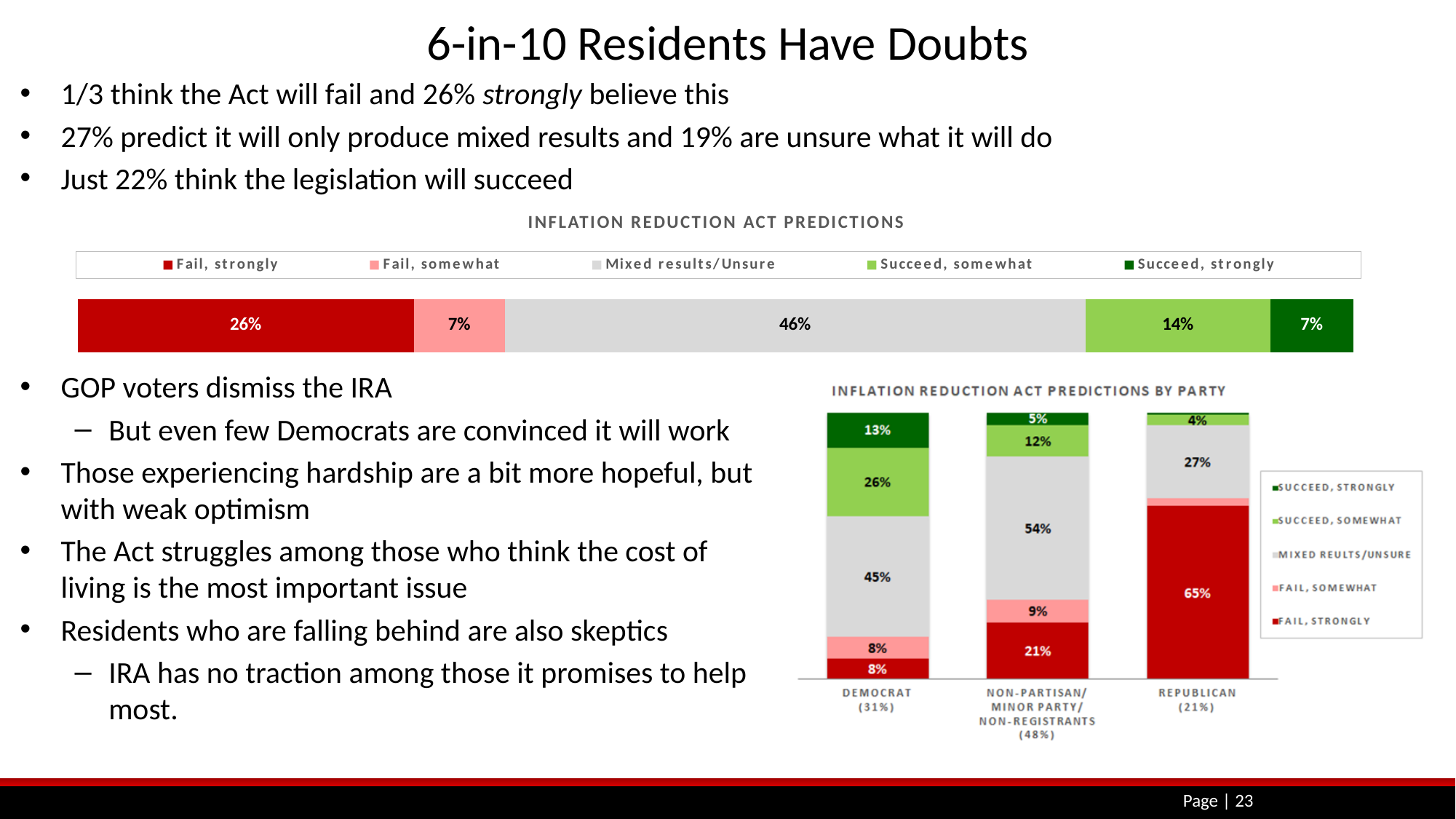
In the 'Inflation Reduction Act Predictions by Party' chart, how many party groups are shown on the x axis? 3 In the 'Inflation Reduction Act Predictions by Party' chart, what percentage of Democrats say 'Succeed, somewhat'? 26% In the 'Inflation Reduction Act Predictions by Party' chart, which party group has the highest 'Fail, strongly' share? Republican In the 'Inflation Reduction Act Predictions' chart, what percentage is shown for 'Fail, strongly'? 26% In the 'Inflation Reduction Act Predictions' chart, what is the difference between 'Fail, strongly' and 'Succeed, strongly'? 19% In the 'Inflation Reduction Act Predictions' chart, what percentage is shown for 'Mixed results/Unsure'? 46% In the 'Inflation Reduction Act Predictions' chart, how many series does the legend list? 5 In the 'Inflation Reduction Act Predictions by Party' chart, what percentage of Republicans say 'Fail, strongly'? 65% In the 'Inflation Reduction Act Predictions' chart, which segment is the largest? Mixed results/Unsure What kind of chart is 'Inflation Reduction Act Predictions by Party'? Stacked bar chart In the 'Inflation Reduction Act Predictions by Party' chart, what percentage of Non-Partisan/Minor Party/Non-Registrants say 'Mixed results/Unsure'? 54% In the 'Inflation Reduction Act Predictions' chart, what colour is the 'Succeed, strongly' segment? Dark green